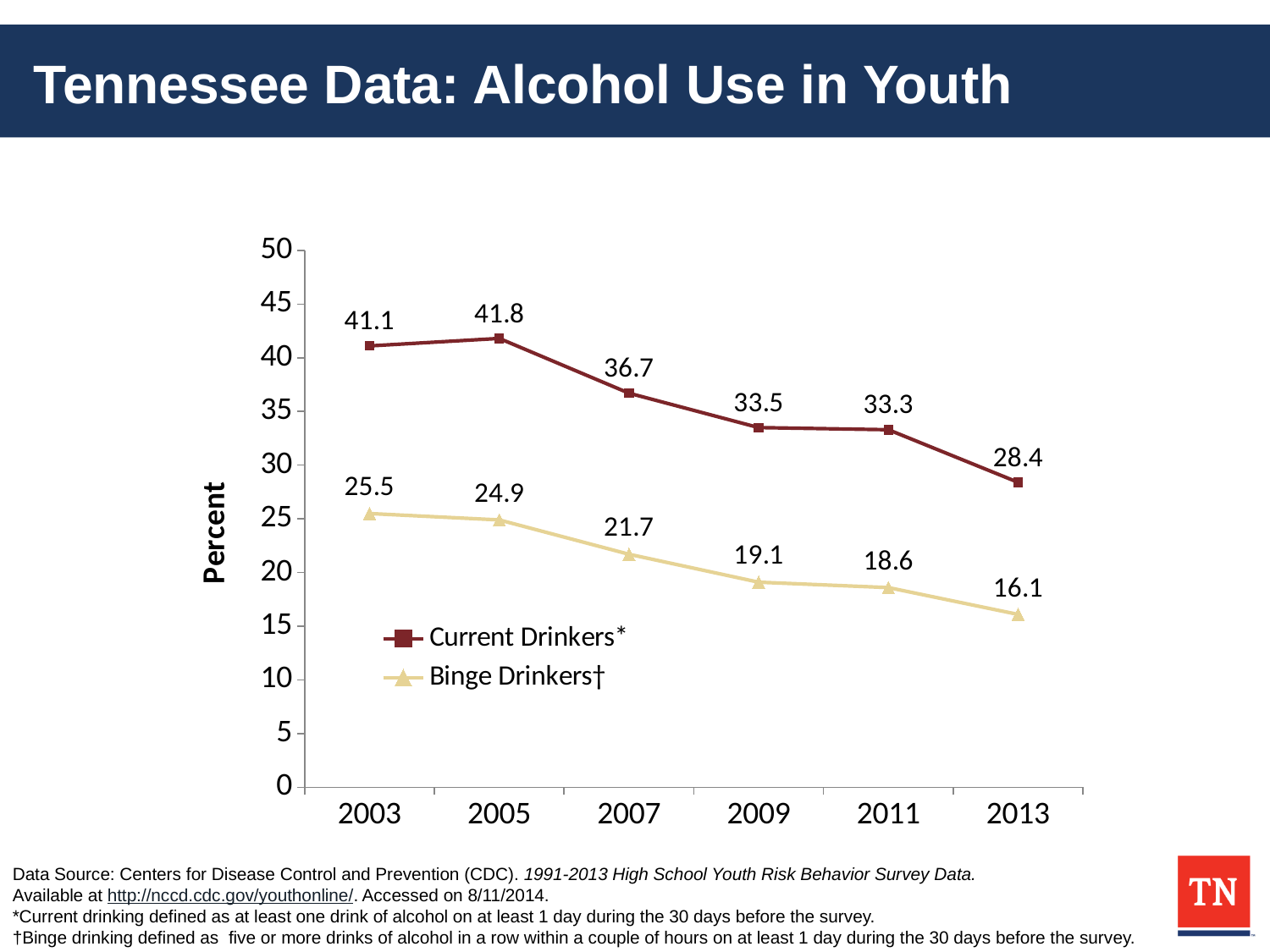
What is the label on the y axis? Percent How many years are plotted on the x axis? 6 What is the difference between the Current Drinkers and Binge Drinkers percentages in 2013? 12.3 In which year was the Binge Drinkers percentage lowest? 2013 How many series does the legend list? 2 In which year was the Current Drinkers percentage highest? 2005 Does the Binge Drinkers percentage generally rise or fall from 2003 to 2013? Fall By how much did the Current Drinkers percentage fall from 2003 to 2013? 12.7 What was the percentage of Current Drinkers in 2007? 36.7 What kind of chart is shown on the slide? Line chart Which was larger in 2009: the Current Drinkers percentage or the Binge Drinkers percentage? Current Drinkers What was the percentage of Binge Drinkers in 2011? 18.6